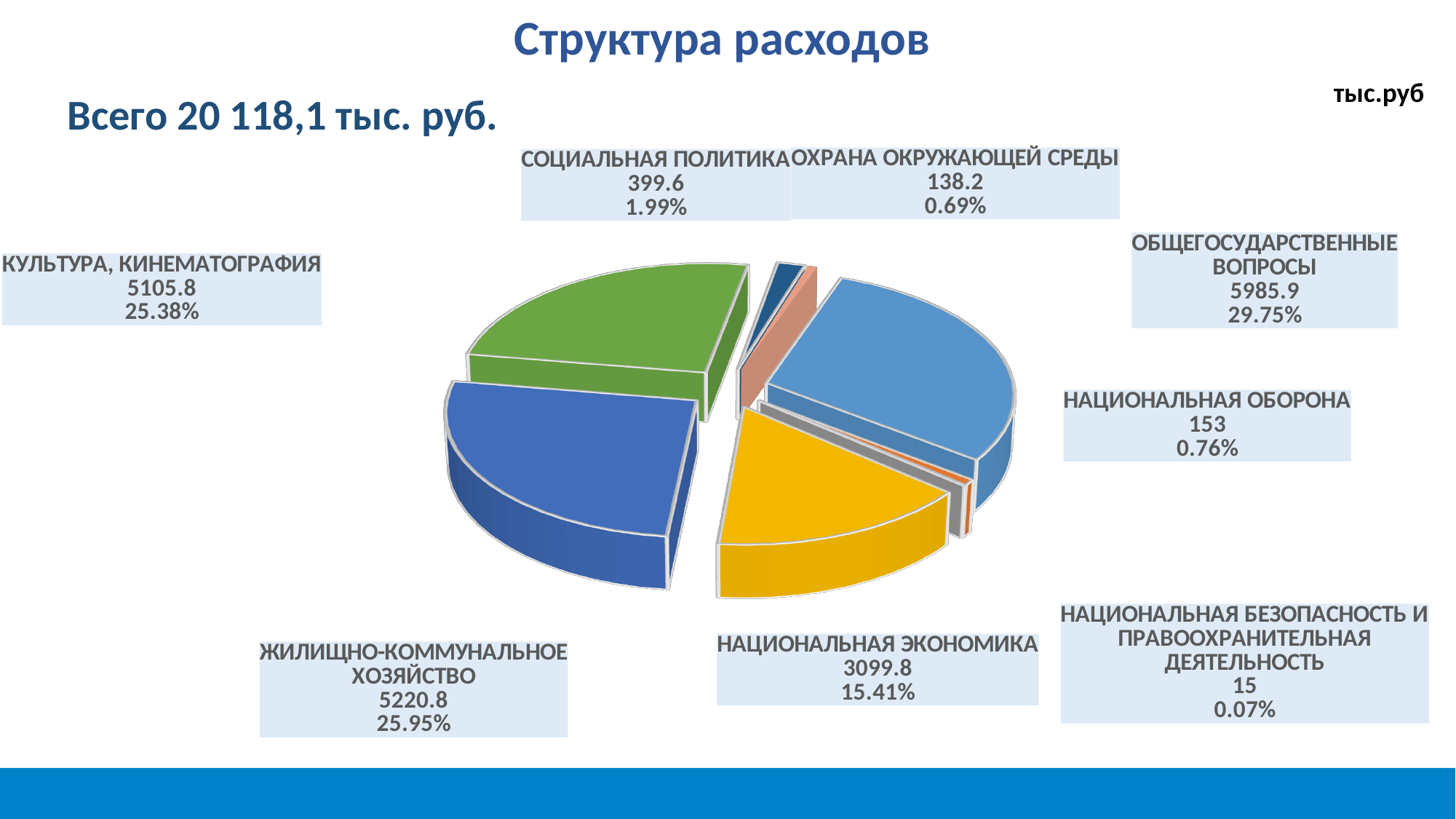
What is the difference between the values for Общегосударственные вопросы and Жилищно-коммунальное хозяйство? 765.1 What kind of chart is shown on the slide? Pie chart Which category has the largest share of expenditures? Общегосударственные вопросы What is the difference between the values for Национальная оборона and Охрана окружающей среды? 14.8 What share of expenditures does Культура, кинематография account for? 25.38% Which category has the smallest share of expenditures? Национальная безопасность и правоохранительная деятельность What share of expenditures does Жилищно-коммунальное хозяйство account for? 25.95% What is the total amount of expenditures stated on the slide? 20 118,1 тыс. руб. What is the value for Национальная экономика? 3099.8 What is the value for Общегосударственные вопросы? 5985.9 How many categories are shown in the pie chart? 8 Which is larger: the value for Социальная политика or the value for Национальная оборона? Социальная политика